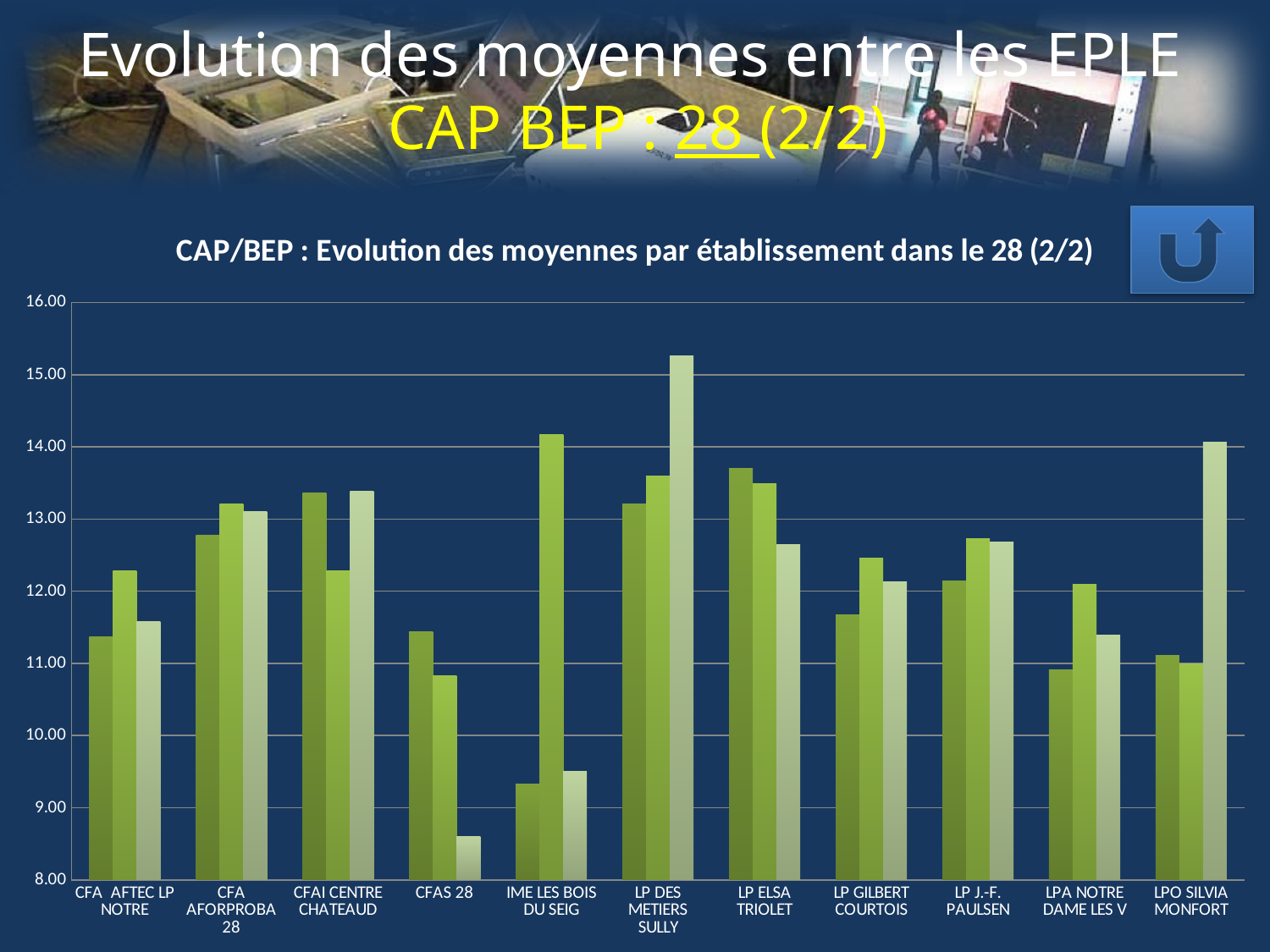
What is the title of the chart? CAP/BEP : Evolution des moyennes par établissement dans le 28 (2/2) What is the lowest value shown on the y axis of the chart? 8.00 Is the tallest bar for LP DES METIERS SULLY greater or less than 15.00? greater What type of chart is shown on the slide? bar chart How many establishments (categories) are shown on the x axis of the chart? 11 Which establishment has the shortest bar in the chart? CFAS 28 How many bars are plotted for each establishment in the chart? 3 Which establishment has the tallest bar in the chart? LP DES METIERS SULLY Which is larger: the first bar for LP ELSA TRIOLET or the first bar for LP GILBERT COURTOIS? LP ELSA TRIOLET Is the shortest bar for CFAS 28 greater or less than 9.00? less Is the first (darkest) bar for IME LES BOIS DU SEIG greater or less than 10.00? less